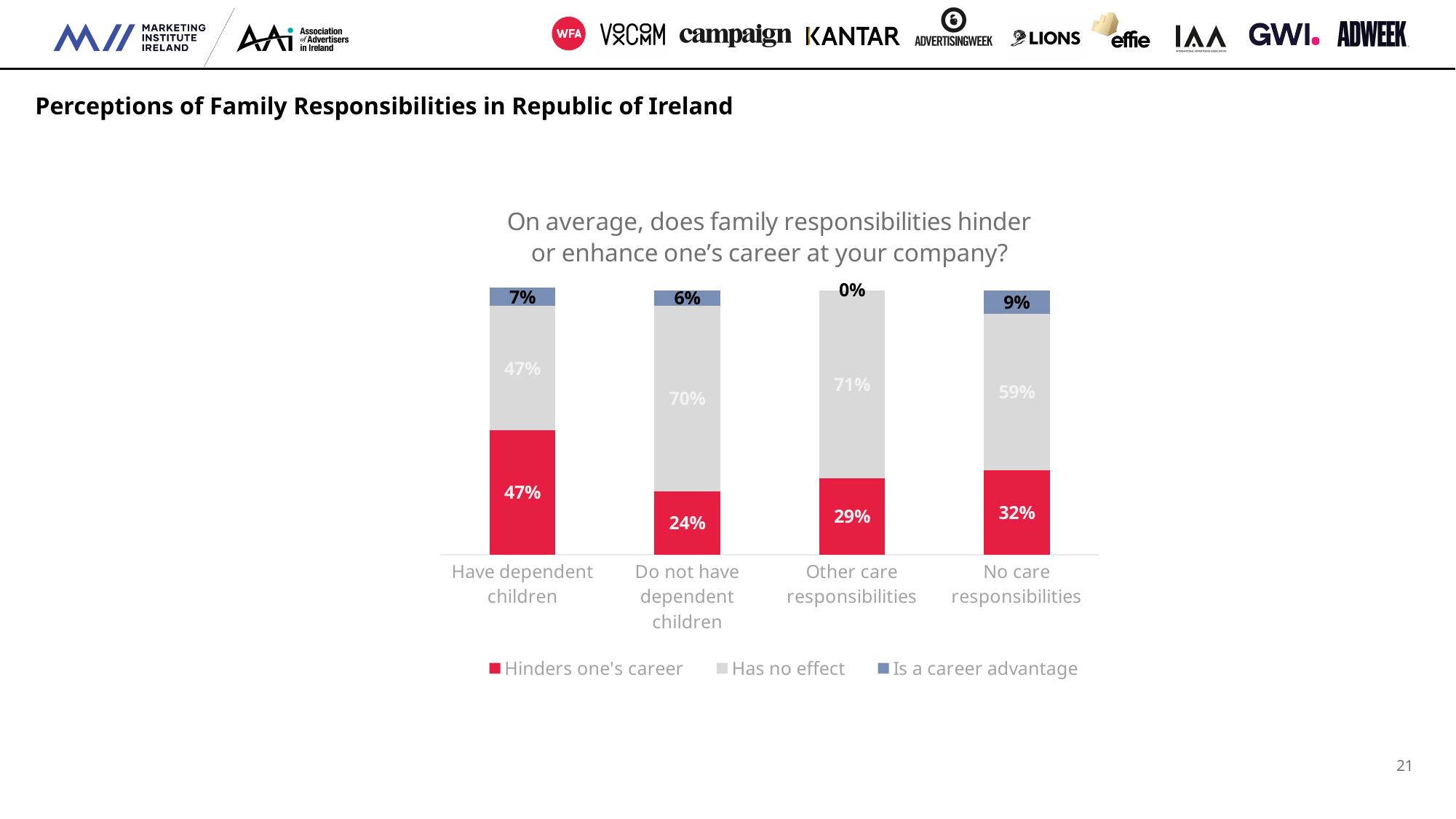
Which is larger: the 'Hinders one's career' value for 'No care responsibilities' or for 'Other care responsibilities'? No care responsibilities What is the 'Is a career advantage' value for 'No care responsibilities'? 9% What kind of chart is shown on the slide? Stacked bar chart How many series does the legend list? 3 How many categories are shown on the x axis? 4 What is the total of the stacked bar for 'No care responsibilities'? 100% Which category has the highest 'Hinders one's career' value? Have dependent children What is the 'Hinders one's career' value for 'Do not have dependent children'? 24% What is the difference between the 'Has no effect' values for 'Do not have dependent children' and 'Have dependent children'? 23 percentage points What is the 'Has no effect' value for 'Other care responsibilities'? 71% Which category has the lowest 'Is a career advantage' value? Other care responsibilities What percentage of respondents who have dependent children say family responsibilities hinder one's career? 47%